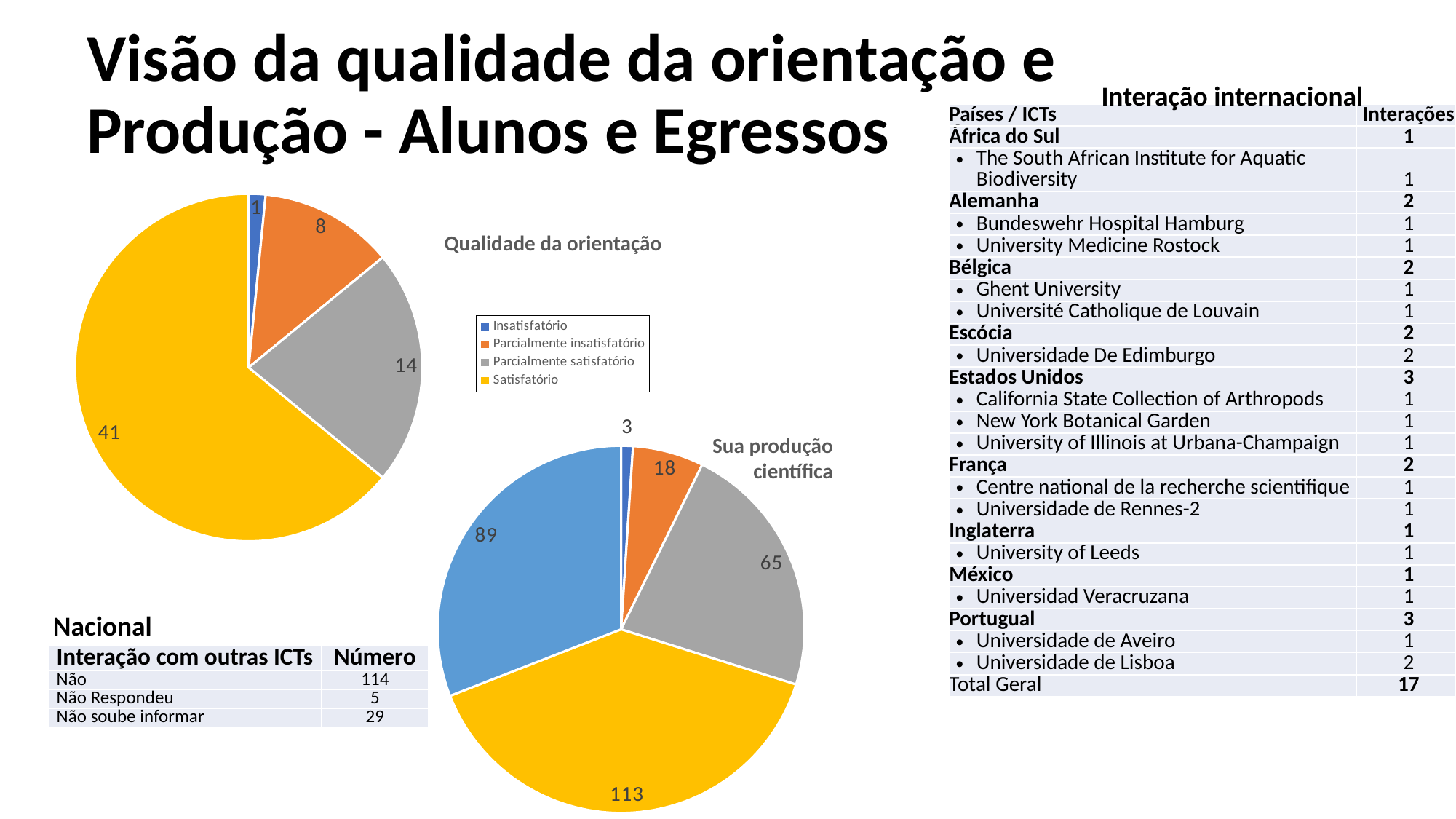
In the 'Qualidade da orientação' pie chart, what is the difference between the Satisfatório and Parcialmente satisfatório values? 27 How many slices does the 'Sua produção científica' pie chart have? 5 What type of chart is 'Sua produção científica'? Pie chart In the 'Sua produção científica' pie chart, what is the value of the largest slice? 113 In the 'Qualidade da orientação' pie chart, which category has the largest slice? Satisfatório In the 'Sua produção científica' pie chart, what is the sum of all the slice values? 288 In the 'Qualidade da orientação' pie chart, what is the value for Satisfatório? 41 In the 'Qualidade da orientação' pie chart, which category has the smallest slice? Insatisfatório In the 'Qualidade da orientação' pie chart, what is the value for Parcialmente satisfatório? 14 How many categories does the legend of the 'Qualidade da orientação' pie chart list? 4 In the 'Sua produção científica' pie chart, what is the value of the smallest slice? 3 In the 'Qualidade da orientação' pie chart, what is the value for Parcialmente insatisfatório? 8